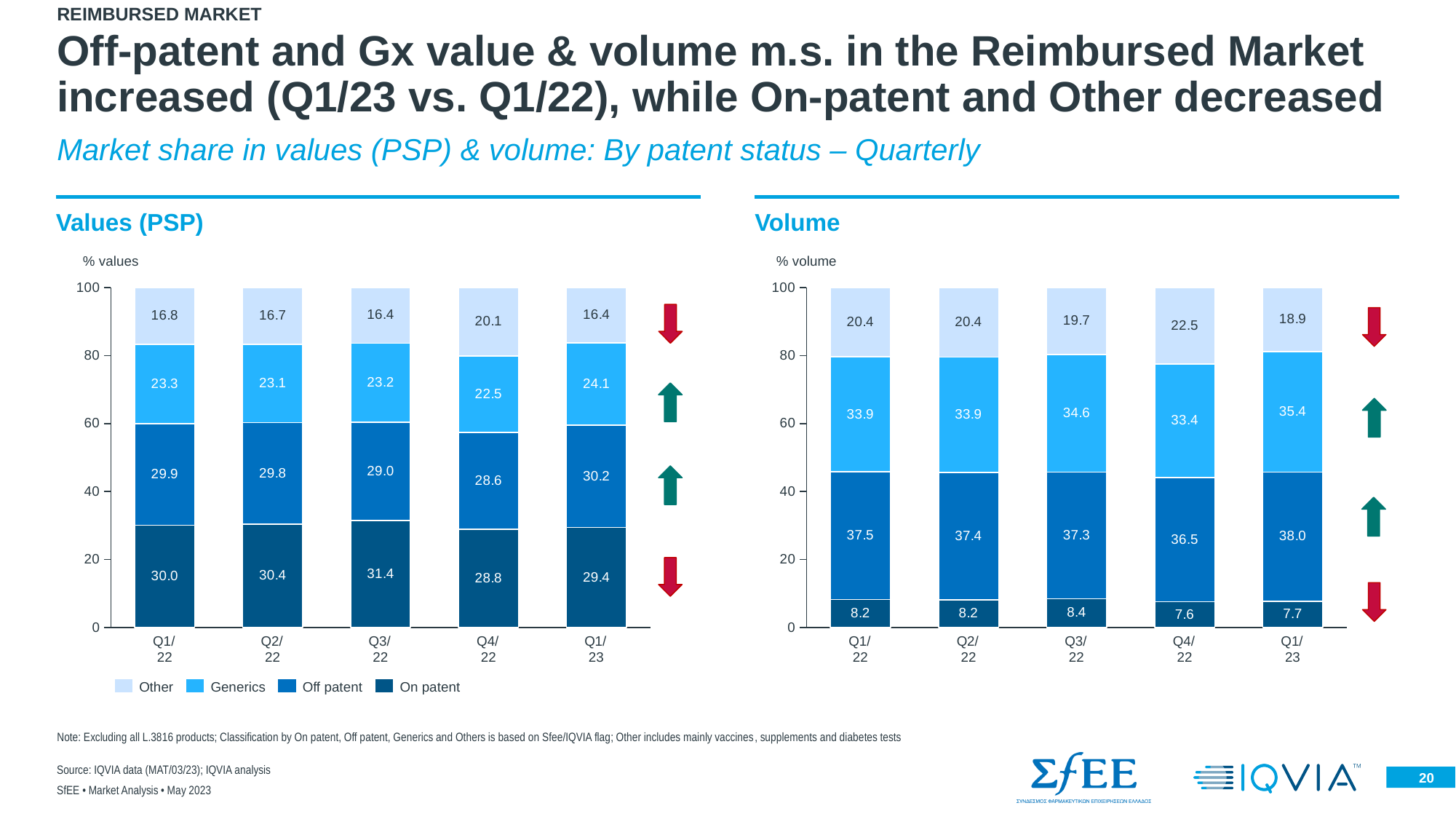
What kind of chart is the Volume chart? Stacked bar chart In the Volume chart, what is the On patent share in Q1/22? 8.2 In the Values (PSP) chart, which quarter has the lowest Off patent share? Q4/22 How many series does the legend list? 4 In the Volume chart, what is the difference between the Other share in Q4/22 and in Q1/23? 3.6 In the Volume chart, is the On patent share larger in Q3/22 or in Q4/22? Q3/22 In the Values (PSP) chart, what is the Other share in Q4/22? 20.1 In the Values (PSP) chart, what is the difference between the Generics share in Q1/23 and in Q1/22? 0.8 How many quarters are shown on the x axis of the Values (PSP) chart? 5 In the Volume chart, which quarter has the highest Off patent share? Q1/23 In the Values (PSP) chart, what is the On patent share in Q1/23? 29.4 In the Volume chart, what is the Generics share in Q1/23? 35.4